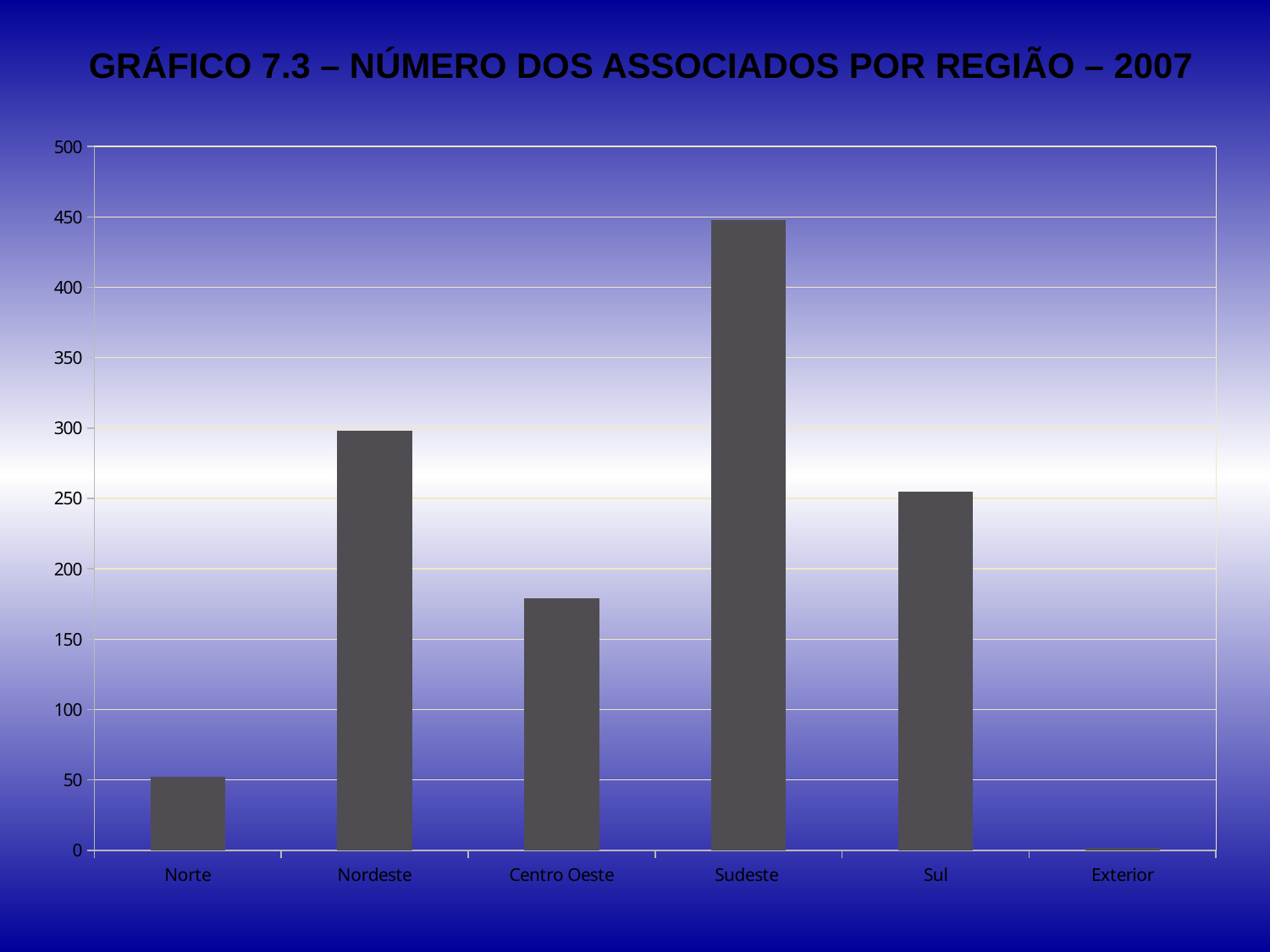
Which has more associates, Nordeste or Sul? Nordeste Is the value for Sul greater or less than 200? greater Is the value for Centro Oeste greater or less than 200? less Is the value for Nordeste greater or less than 250? greater Which has more associates, Centro Oeste or Norte? Centro Oeste Which region has the highest number of associates? Sudeste How many regions are shown on the x axis of the chart? 6 What is the title of the chart? GRÁFICO 7.3 – NÚMERO DOS ASSOCIADOS POR REGIÃO – 2007 Which region has the lowest number of associates? Exterior What kind of chart is shown on the slide? bar chart